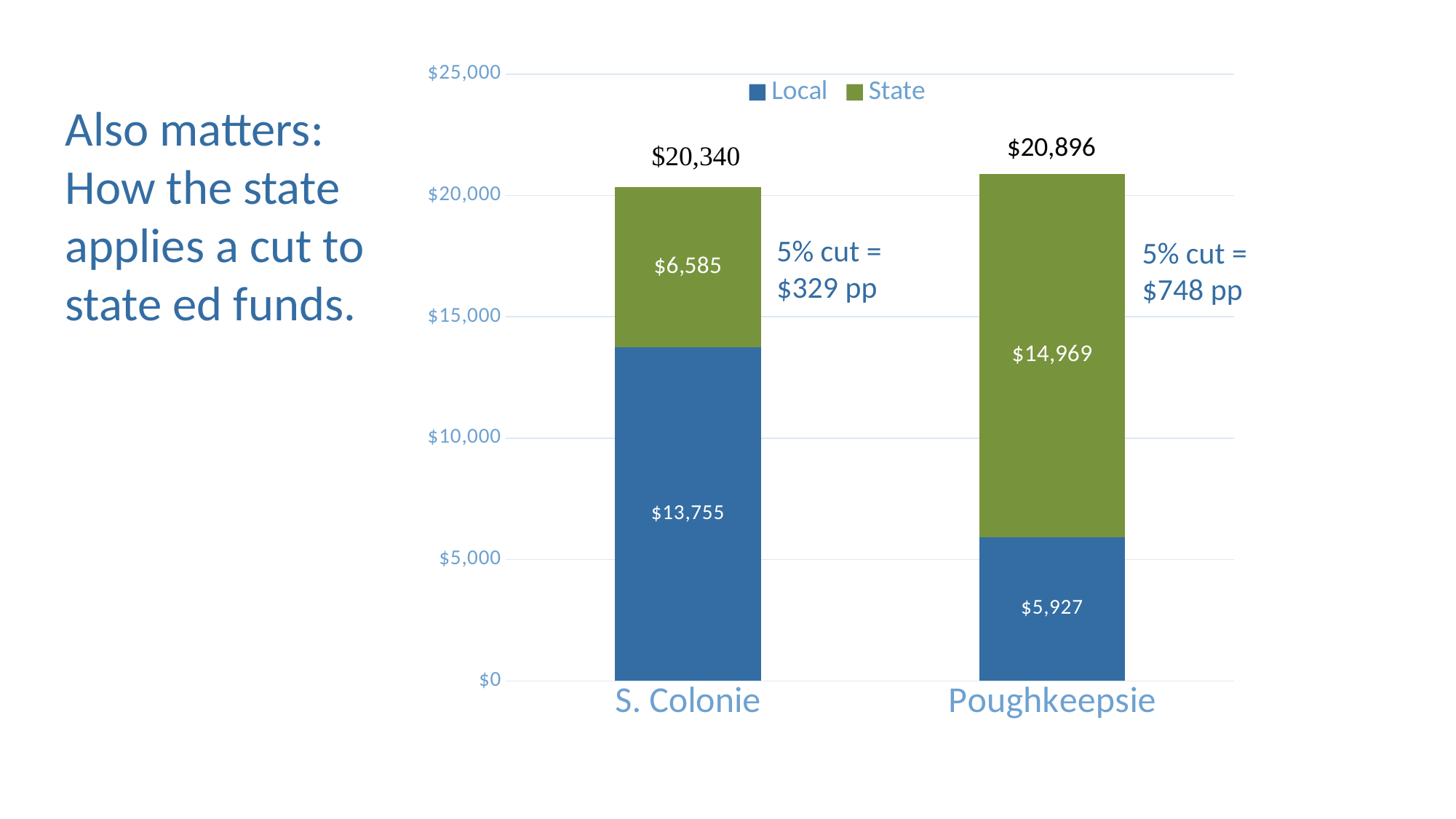
What is the State value for S. Colonie? $6,585 How many series does the legend list? 2 What is the State value for Poughkeepsie? $14,969 What kind of chart is shown on the slide? Stacked bar chart What is the Local value for Poughkeepsie? $5,927 What is the difference between the State values for Poughkeepsie and S. Colonie? $8,384 Which district has the larger Local value, S. Colonie or Poughkeepsie? S. Colonie What is the total of the stacked bar for S. Colonie? $20,340 What is the total of the stacked bar for Poughkeepsie? $20,896 How many categories are shown on the x axis? 2 What is the Local value for S. Colonie? $13,755 Which district has the larger State value, S. Colonie or Poughkeepsie? Poughkeepsie